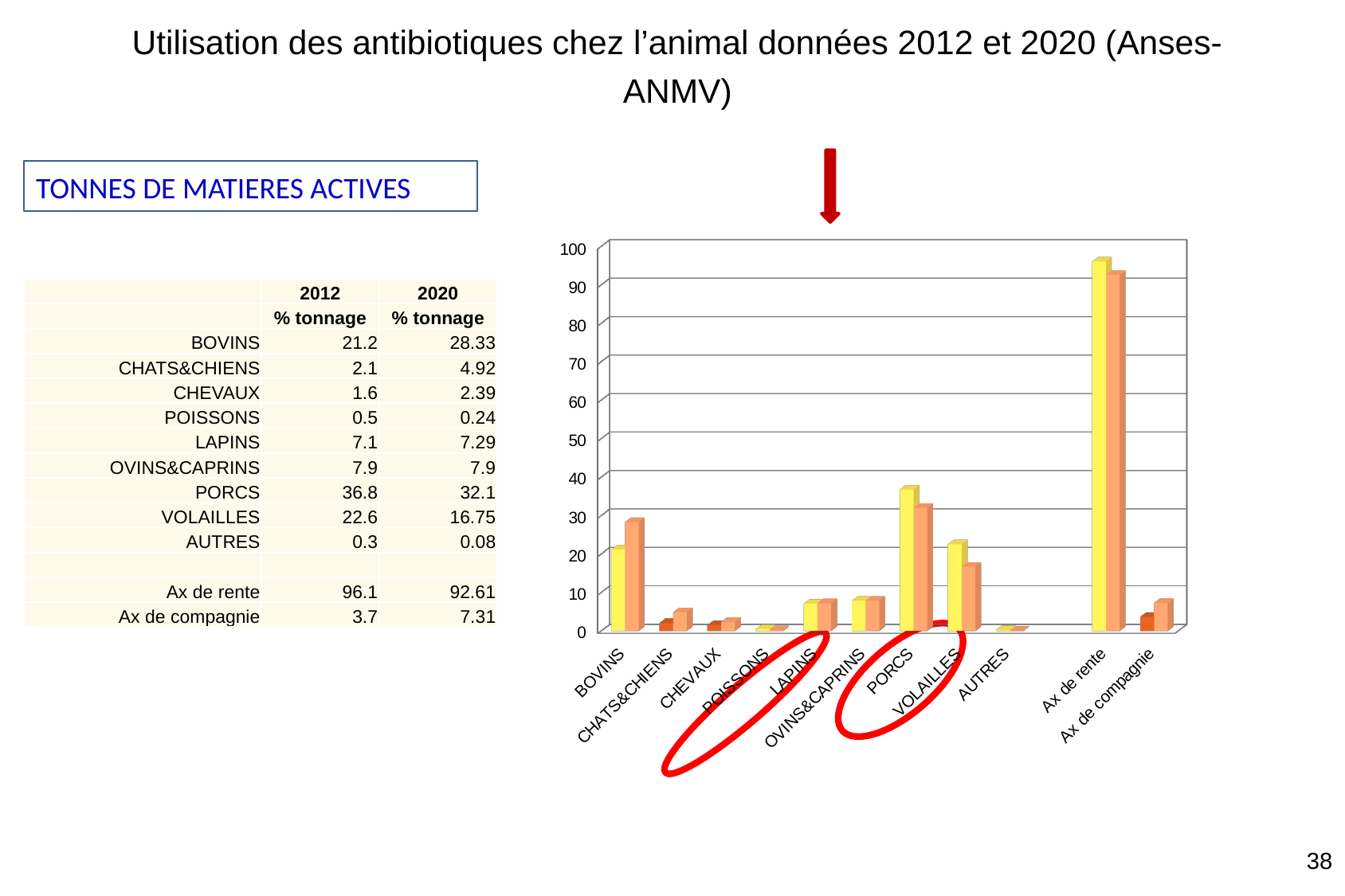
By how much did the PORCS value decrease from 2012 to 2020? 4.7 What is the 2020 % tonnage value for BOVINS? 28.33 Which category has the lowest 2020 value? AUTRES What is the 2012 % tonnage value for PORCS? 36.8 Among the individual animal species (excluding the 'Ax de rente' and 'Ax de compagnie' totals), which category has the highest 2012 value? PORCS Which category has the tallest bars in the chart? Ax de rente Which two pairs of categories are circled in red on the chart's x axis? POISSONS/LAPINS and PORCS/VOLAILLES How many categories are shown along the x axis of the chart? 11 Is the 2012 value for Ax de rente greater or less than 90? greater Which is larger in 2020: the value for BOVINS or the value for VOLAILLES? BOVINS What kind of chart is shown on the slide? bar chart What is the 2020 % tonnage value for Ax de compagnie? 7.31